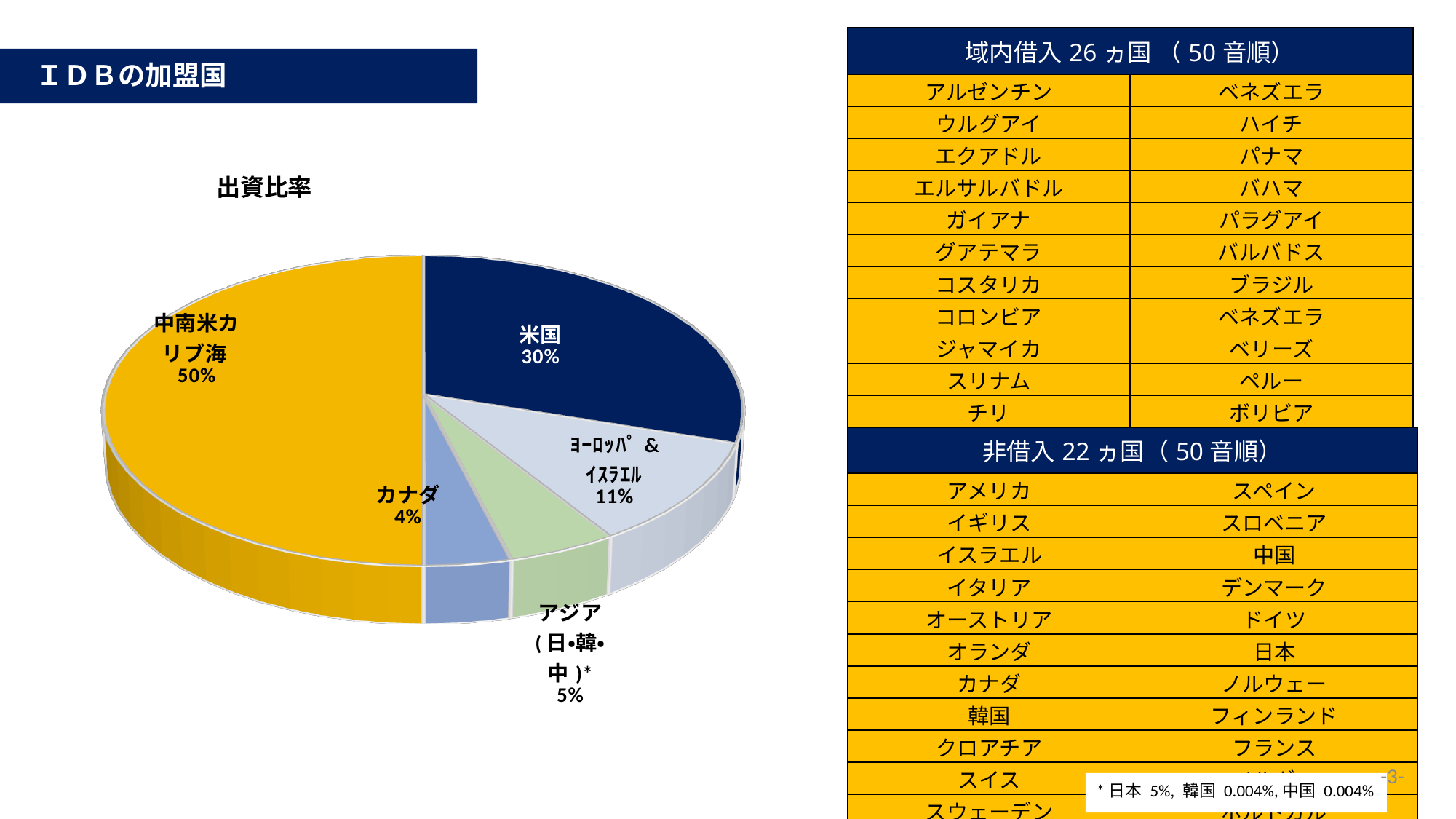
Which has a larger share, アジア（日・韓・中） or カナダ? アジア（日・韓・中） What is the value shown for アジア（日・韓・中）? 5% How many slices does the pie chart have? 5 What type of chart is shown on the slide? pie chart What is the difference between the shares of 米国 and ヨーロッパ＆イスラエル? 19% What is the value shown for ヨーロッパ＆イスラエル? 11% What is the title of the pie chart? 出資比率 Which slice of the pie chart is the smallest? カナダ What is the value shown for 米国 in the pie chart? 30% What share of the pie does 中南米カリブ海 hold? 50% Which slice of the pie chart is the largest? 中南米カリブ海 What is the value shown for カナダ? 4%